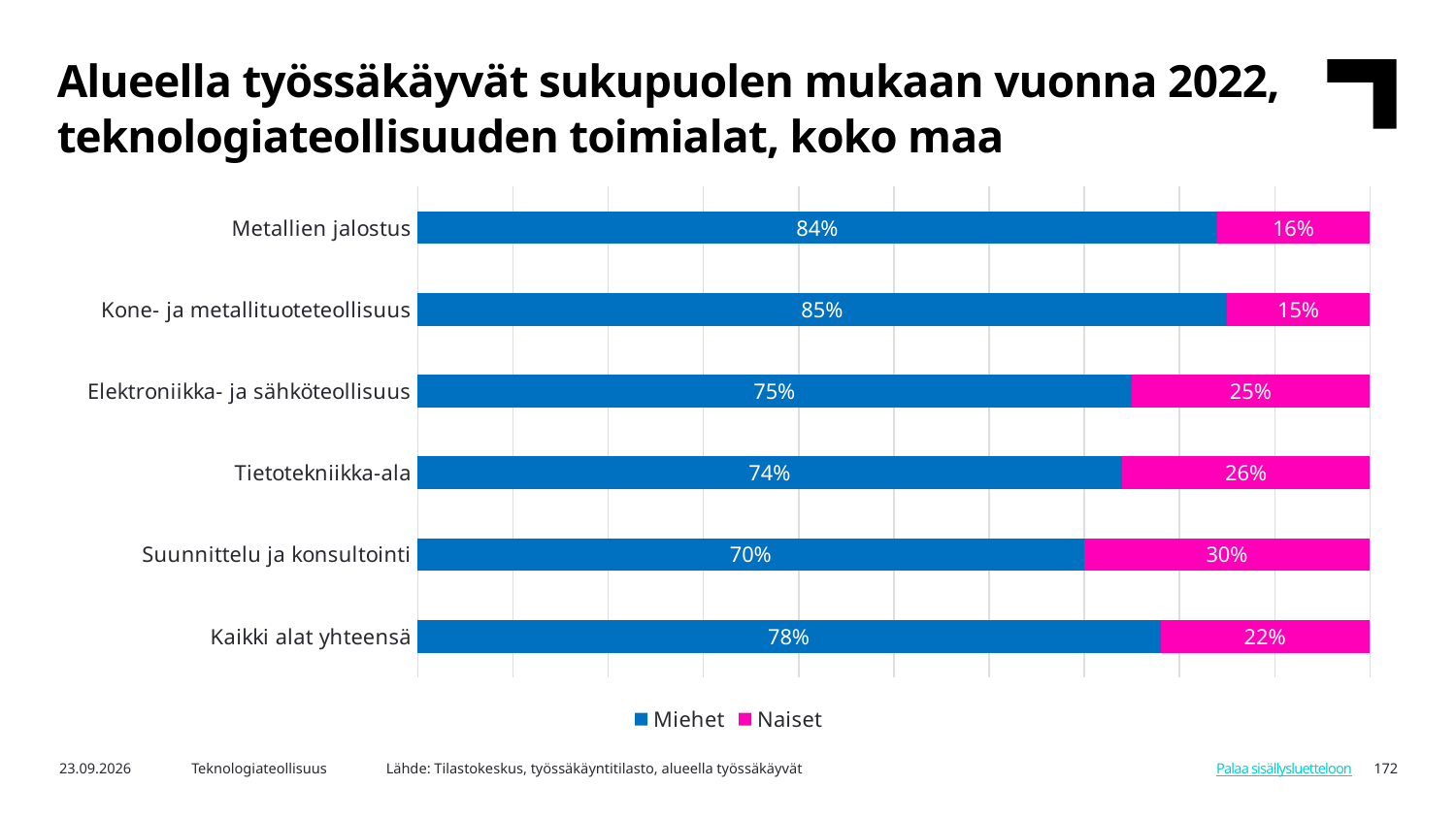
Which has a larger Naiset share, Elektroniikka- ja sähköteollisuus or Kone- ja metallituoteteollisuus? Elektroniikka- ja sähköteollisuus What colour represents the Naiset series? Pink (magenta) How many categories are shown on the chart? 6 Which category has the highest Miehet share? Kone- ja metallituoteteollisuus What is the Miehet share for Tietotekniikka-ala? 74% Which category has the lowest Miehet share? Suunnittelu ja konsultointi What is the Naiset share for Kaikki alat yhteensä? 22% How many series does the legend list? 2 What is the Naiset share for Suunnittelu ja konsultointi? 30% What is the difference between the Naiset shares of Suunnittelu ja konsultointi and Metallien jalostus? 14 percentage points What is the Miehet share for Metallien jalostus? 84% What kind of chart is shown on the slide? Stacked bar chart